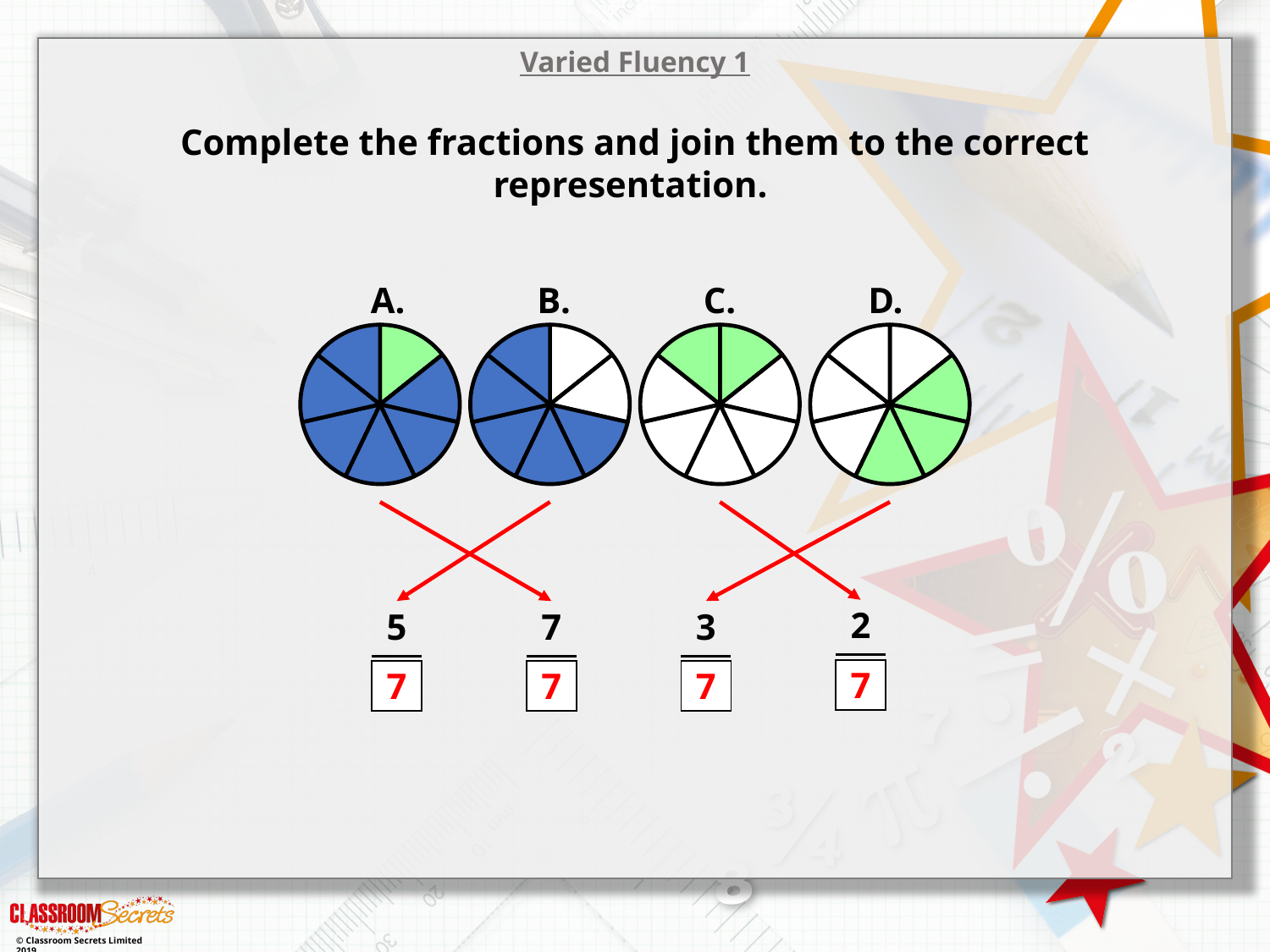
What kind of diagram is used to represent the fractions? Pie chart How many sections of circle C are shaded green? 2 How many more green sections does circle D have than circle C? 1 How many sections of circle A are shaded green? 1 Which of the four circles has the fewest shaded (non-white) sections? C What number is written in the red boxes as the denominator of each fraction? 7 How many equal sections is circle A divided into? 7 How many circle diagrams are shown on the slide? 4 How many sections of circle D are shaded green? 3 How many sections of circle B are shaded blue? 5 What colour are the shaded sections in circle B? Blue Which circle, C or D, has more green sections? D